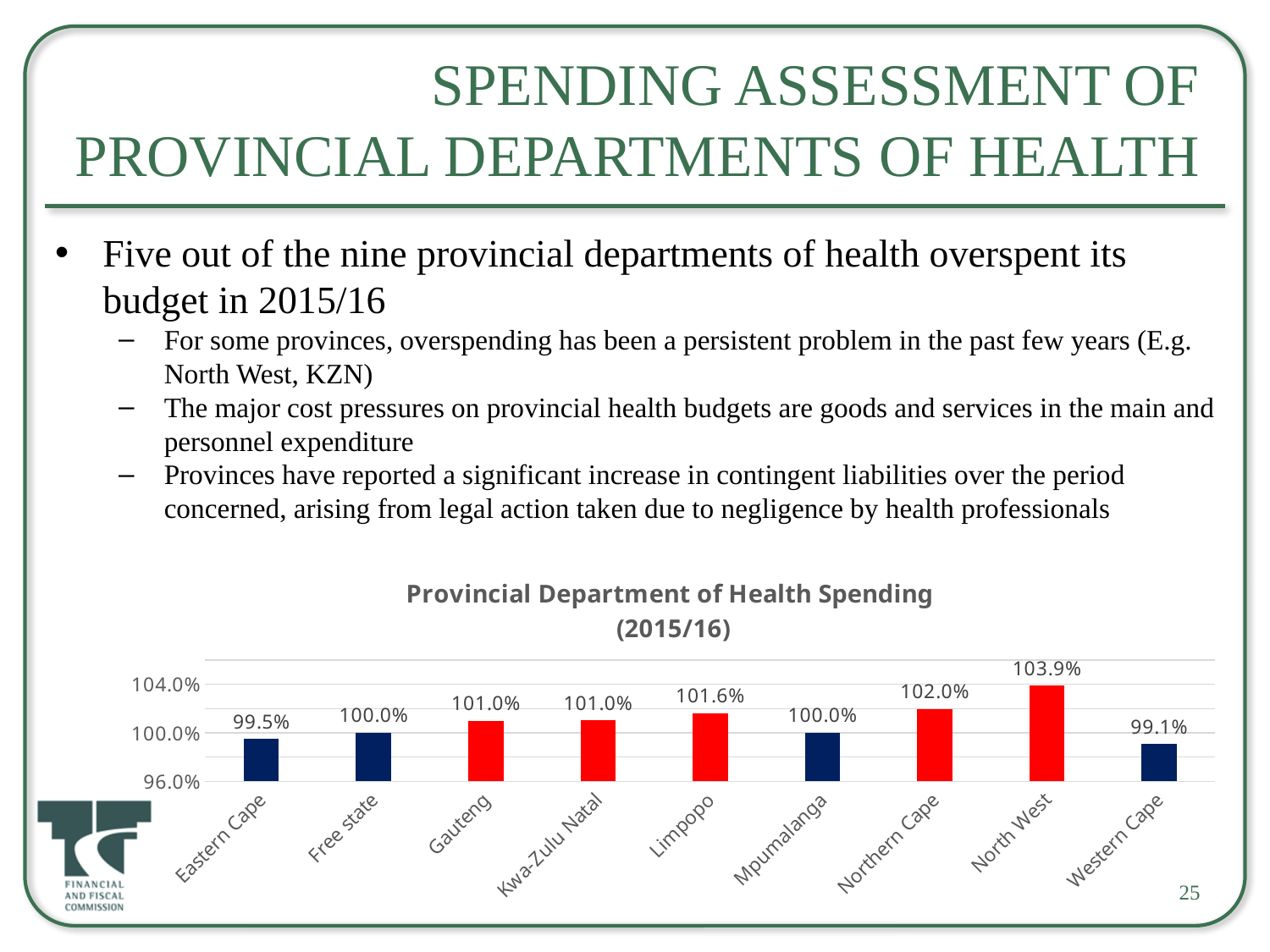
What is the spending value for Eastern Cape? 99.5% How many provinces are shown on the chart? 9 Which has a larger spending value, Northern Cape or Limpopo? Northern Cape What is the spending value for Limpopo? 101.6% Is the value for Gauteng greater or less than 100.0%? greater What is the difference between the spending values for North West and Western Cape? 4.8% Which province has the lowest spending value? Western Cape What is the spending value for North West? 103.9% What colour are the bars for provinces with spending above 100.0%? red Which province has the highest spending value? North West What kind of chart is shown on the slide? bar chart What is the title of the chart? Provincial Department of Health Spending (2015/16)